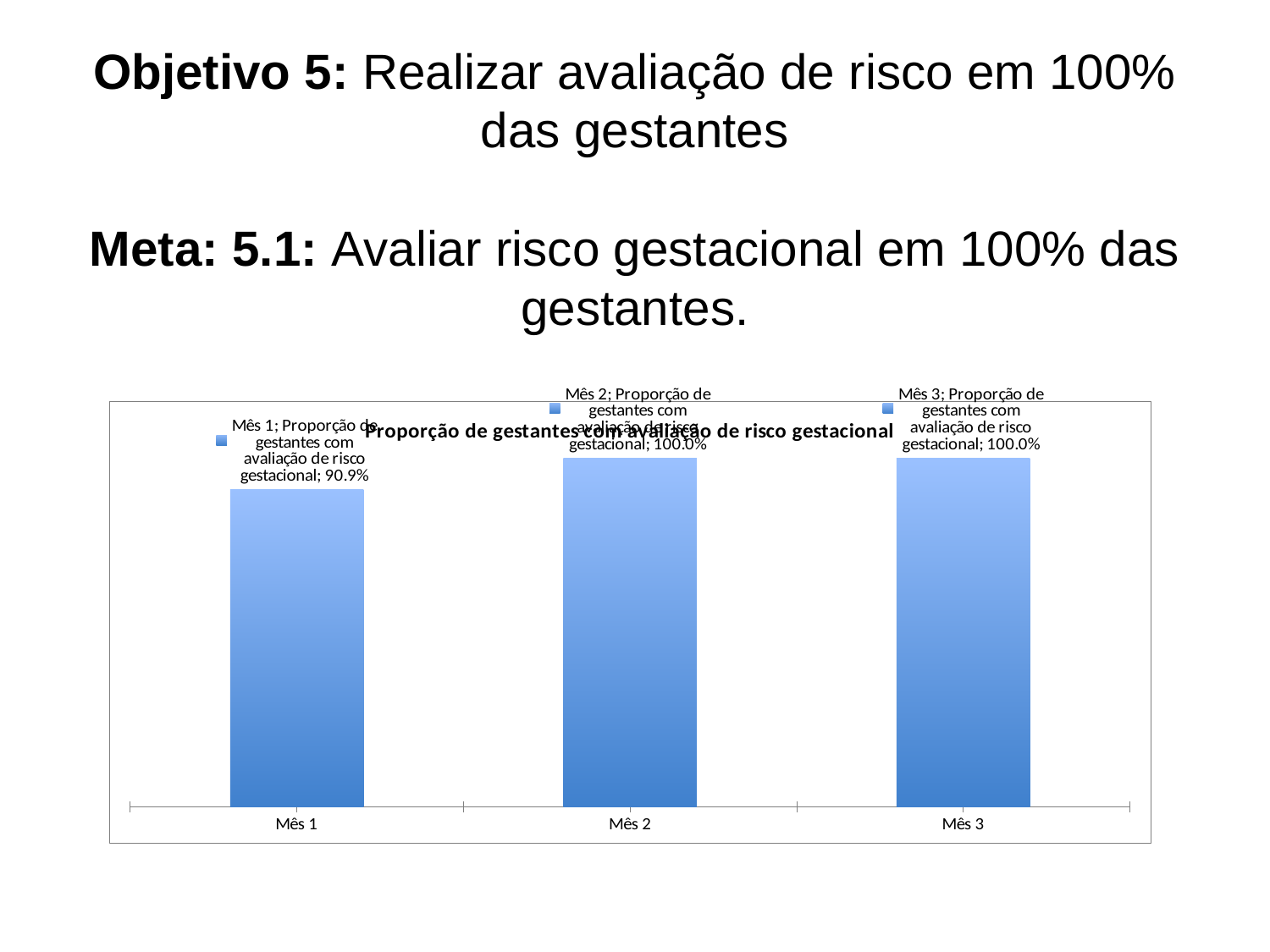
Are the values for Mês 2 and Mês 3 equal? Yes What is the difference between the values for Mês 2 and Mês 1? 9.1% Do the values rise or fall from Mês 1 to Mês 2? Rise Which month has the lowest proportion of gestantes com avaliação de risco gestacional? Mês 1 What is the value for Mês 1 in the chart? 90.9% What kind of chart is shown on the slide? Bar chart What is the value for Mês 3 in the chart? 100.0% How many months are shown on the x axis of the chart? 3 What is the value for Mês 2 in the chart? 100.0% What is the title of the chart? Proporção de gestantes com avaliação de risco gestacional Which is larger, the value for Mês 1 or the value for Mês 3? Mês 3 What colour are the bars in the chart? Blue